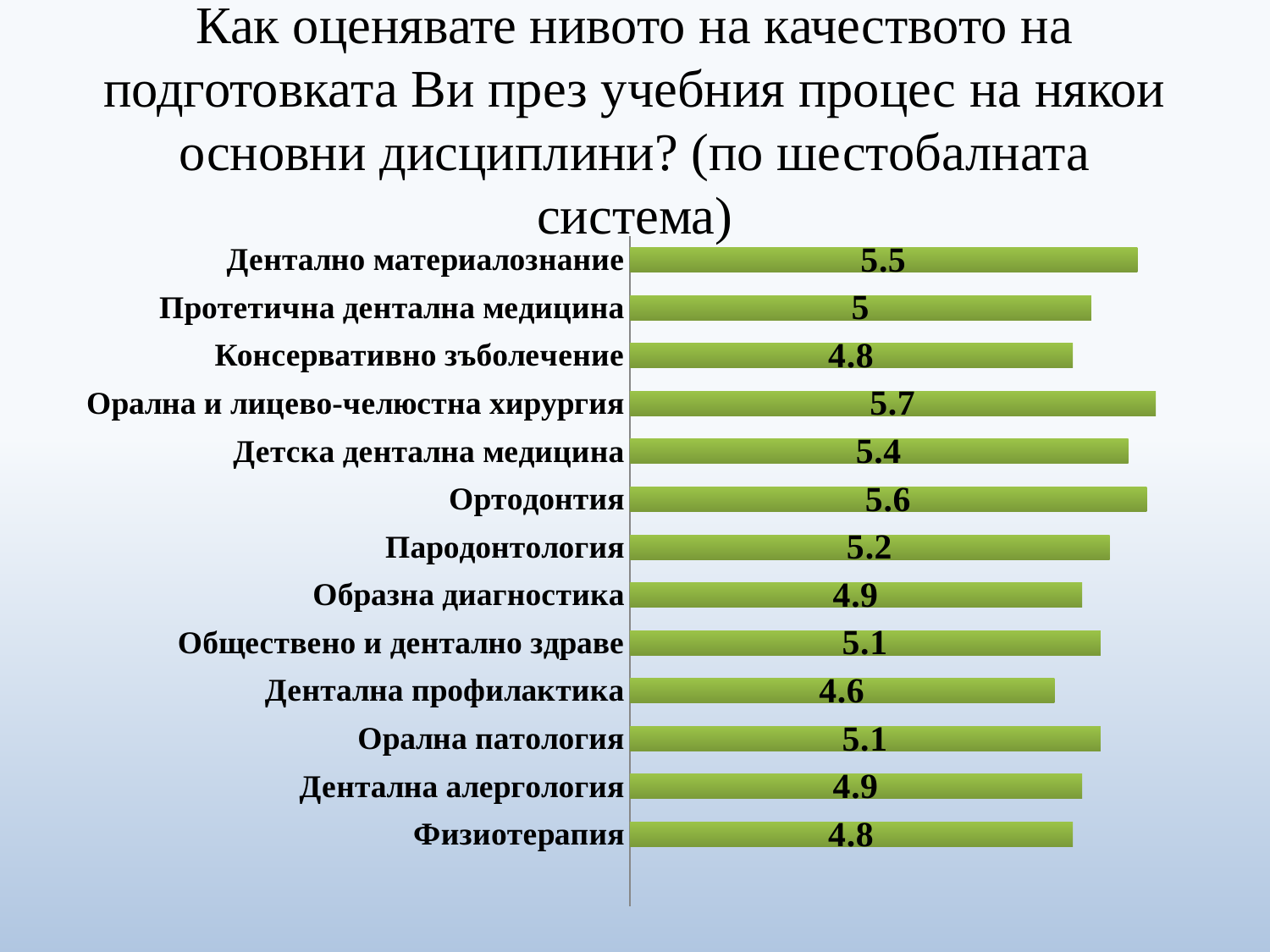
Which has a larger value, Консервативно зъболечение or Обществено и дентално здраве? Обществено и дентално здраве What is the difference between the values for Орална и лицево-челюстна хирургия and Дентална профилактика? 1.1 What kind of chart is shown on the slide? Bar chart What is the value for Пародонтология? 5.2 What is the value for Дентална профилактика? 4.6 What is the value for Дентално материалознание? 5.5 Which has a larger value, Ортодонтия or Детска дентална медицина? Ортодонтия What is the value for Физиотерапия? 4.8 What is the difference between the values for Дентално материалознание and Протетична дентална медицина? 0.5 How many disciplines are shown in the chart? 13 Which discipline has the lowest value? Дентална профилактика Which discipline has the highest value? Орална и лицево-челюстна хирургия